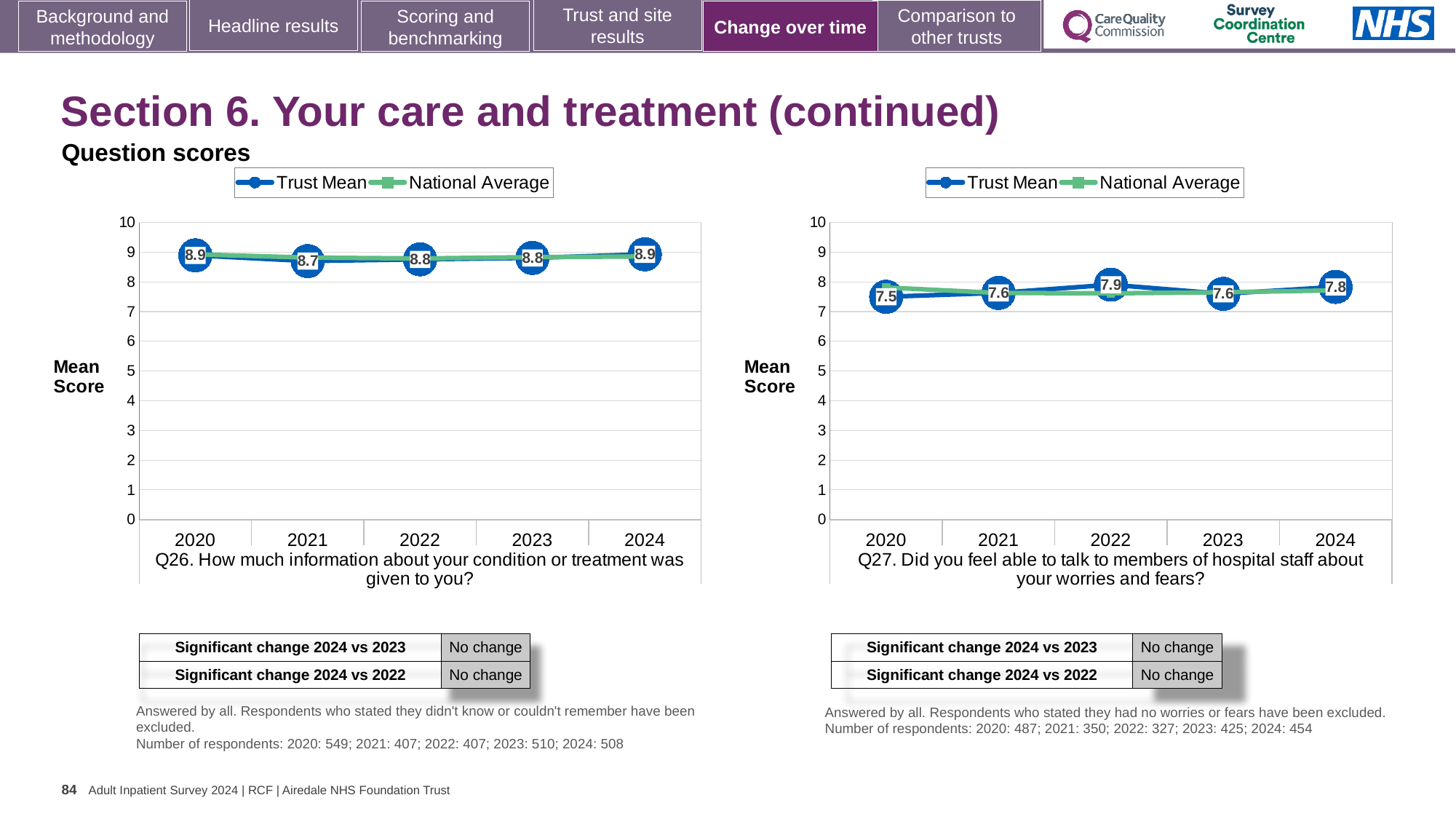
How many series does the legend of the Q27 chart list? 2 On the Q27 chart, which year has the highest Trust Mean score? 2022 On the Q27 chart, what is the Trust Mean score for 2020? 7.5 On the Q26 chart, what is the Trust Mean score for 2021? 8.7 What kind of chart is the Q26 chart? Line chart On the Q27 chart, what is the Trust Mean score for 2022? 7.9 On the Q26 chart, what is the Trust Mean score for 2024? 8.9 On the Q26 chart, which year has the lowest Trust Mean score? 2021 On the Q27 chart, which year has the lowest Trust Mean score? 2020 On the Q26 chart, is the Trust Mean score for 2024 greater or less than 8? greater On the Q27 chart, what is the difference between the Trust Mean scores for 2022 and 2020? 0.4 How many years are plotted on the x axis of the Q26 chart? 5